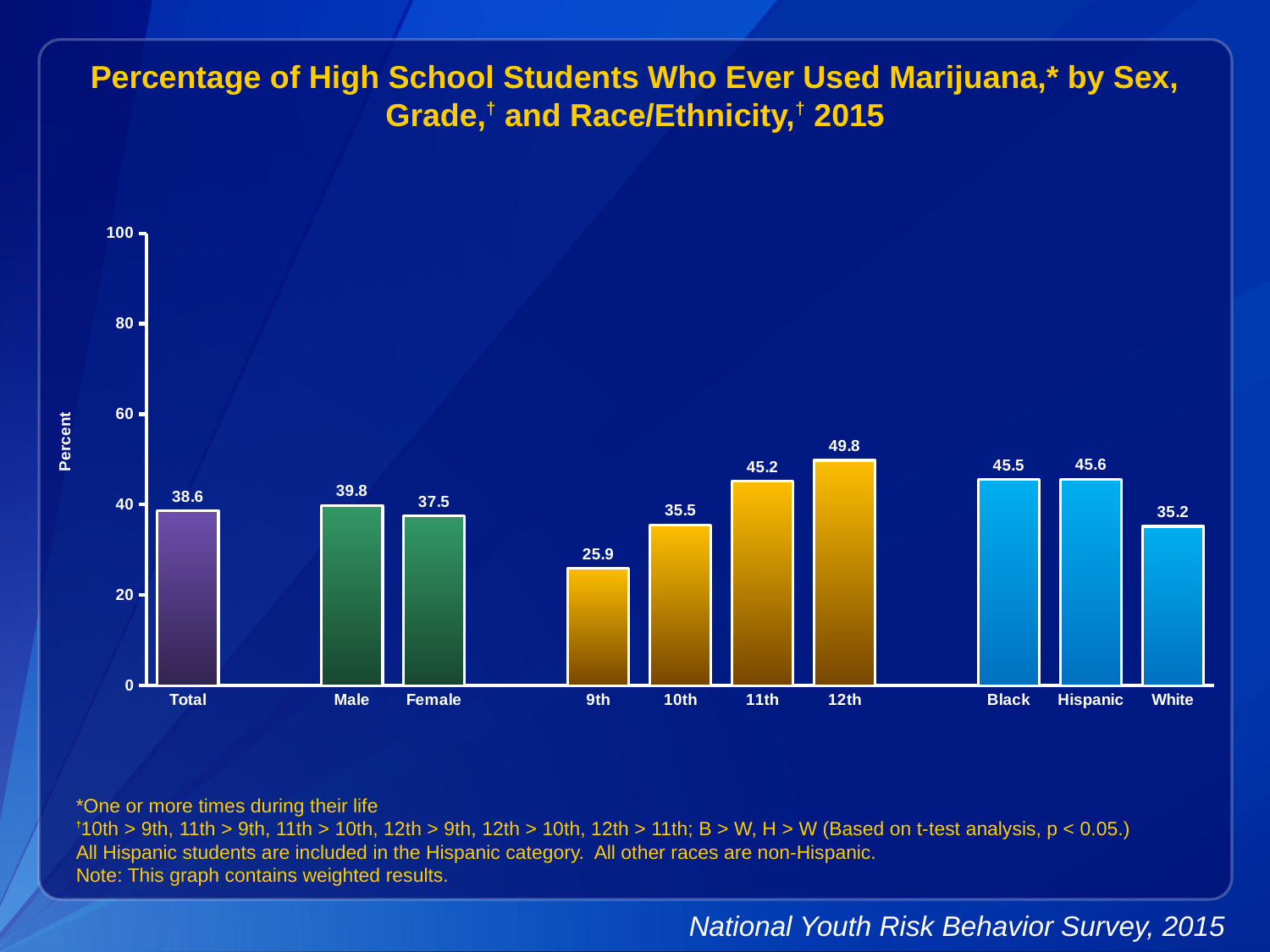
What is the value for Hispanic students? 45.6 Do the values rise or fall from 9th grade to 12th grade? rise What is the value for Total? 38.6 What kind of chart is this? bar chart What is the difference between the Male and Female values? 2.3 What is the difference between the 12th and 9th grade values? 23.9 Which category has the highest value? 12th Which is larger, the value for Black students or the value for White students? Black Which category has the lowest value? 9th How many categories are shown on the x axis? 10 What percentage of 12th grade students ever used marijuana? 49.8 Is the value for 11th grade greater or less than 40? greater